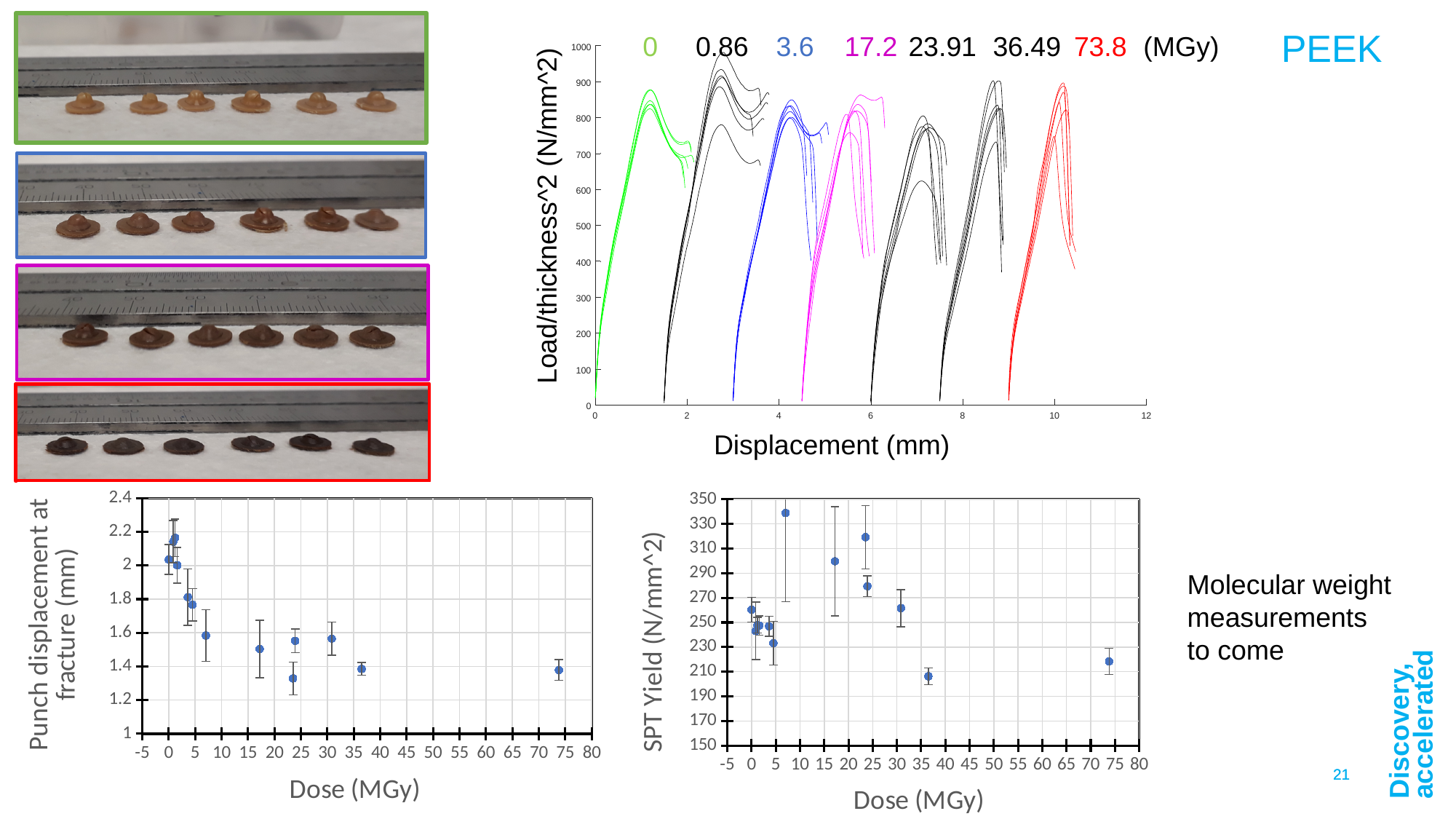
In the top-right Load/thickness^2 chart, which dose level is drawn in red? 73.8 MGy In the top-right Load/thickness^2 chart, how many dose levels (MGy) are listed above the plot? 7 In the bottom-left chart, is the punch displacement at fracture at 0 MGy greater or less than 1.8 mm? greater What kind of chart is the bottom-left chart of Punch displacement at fracture versus Dose? scatter chart What is the x-axis label of the bottom-right SPT Yield chart? Dose (MGy) In the bottom-left chart, is the punch displacement at fracture for the highest dose (about 74 MGy) greater or less than 1.6 mm? less In the bottom-right chart, is the SPT Yield for the highest dose (about 74 MGy) greater or less than 250 N/mm^2? less In the bottom-left chart, which has the larger punch displacement at fracture: the point at 0 MGy or the point at about 74 MGy? 0 MGy What kind of chart is the top-right chart of Load/thickness^2 versus Displacement? line chart In the bottom-left chart, does the punch displacement at fracture generally rise or fall as dose increases? fall